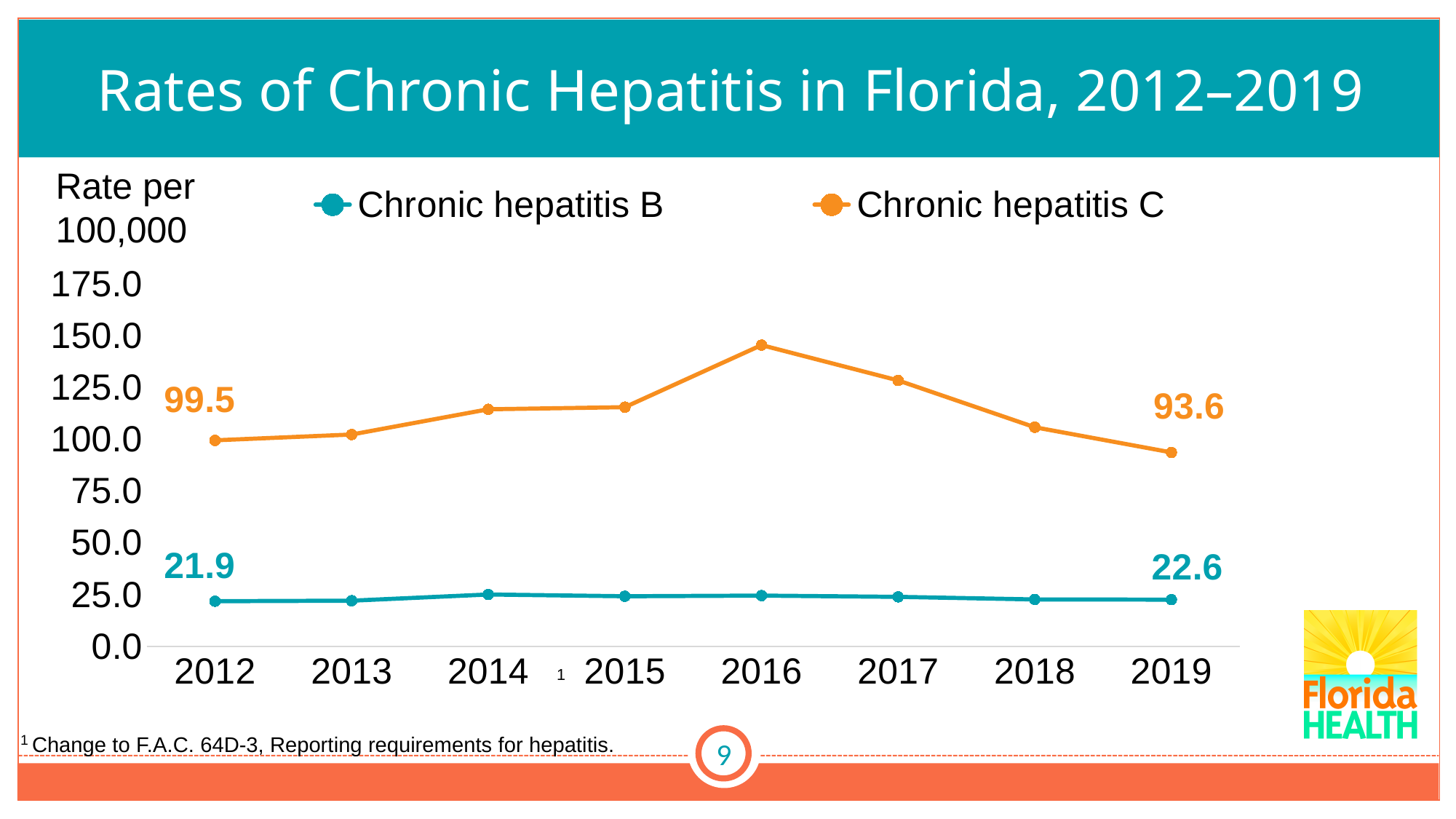
What is the rate of chronic hepatitis C in 2019? 93.6 Which is larger, the chronic hepatitis B rate in 2012 or in 2019? 2019 What is the rate of chronic hepatitis C in 2012? 99.5 What kind of chart is shown on the slide? Line chart In which year does the chronic hepatitis C rate peak? 2016 By how much did the chronic hepatitis C rate change from 2012 to 2019? 5.9 What is the rate of chronic hepatitis B in 2012? 21.9 What is the rate of chronic hepatitis B in 2019? 22.6 How many series does the legend list? 2 Is the chronic hepatitis B rate in 2016 greater or less than 50.0? less How many years are shown on the x axis? 8 Is the chronic hepatitis C rate in 2016 greater or less than 125.0? greater